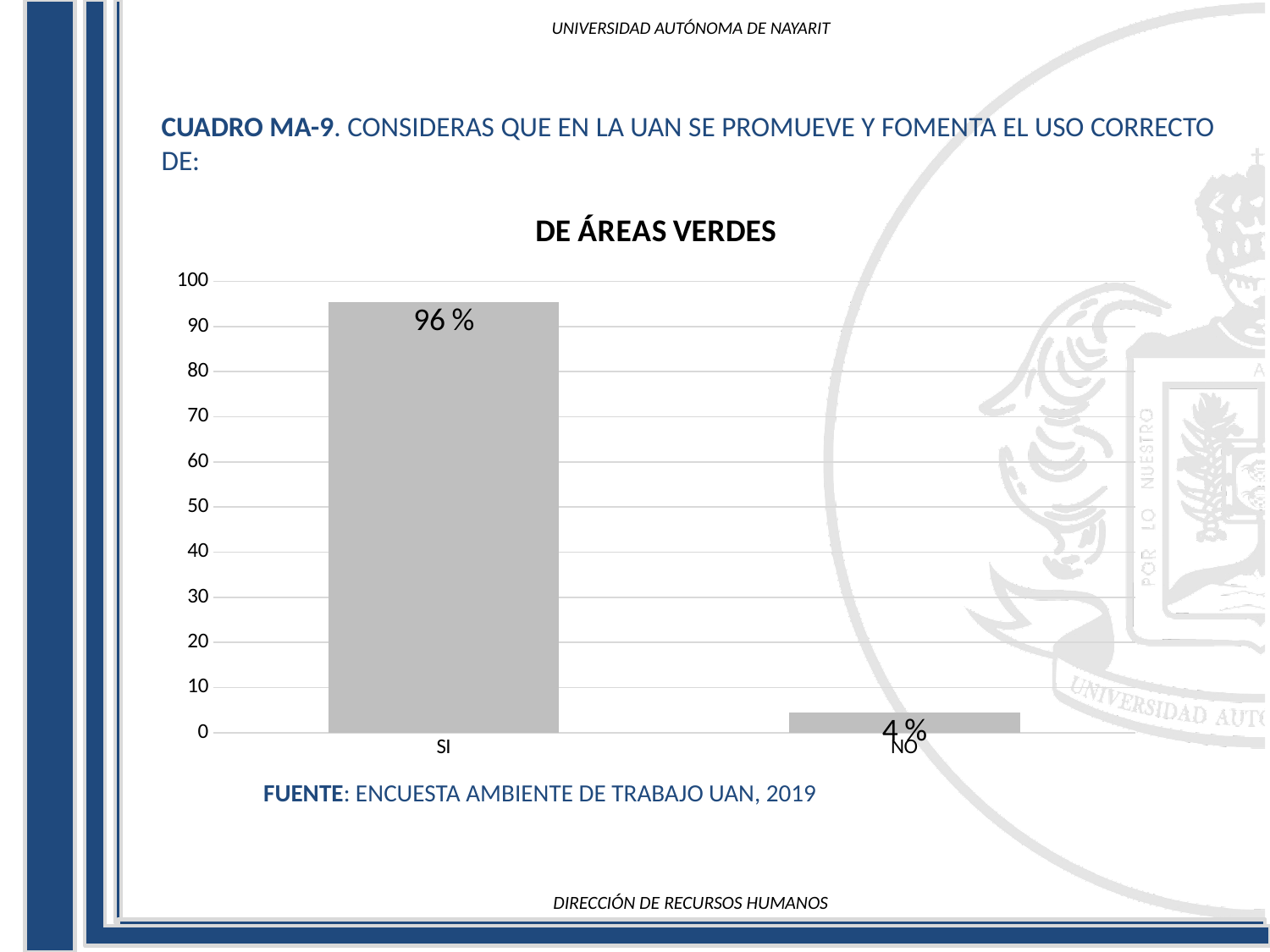
Is the value for NO greater or less than 10? less Which is larger, the value for SI or the value for NO? SI What is the value for NO? 4 % Which category has the lowest value? NO What is the title of the chart? DE ÁREAS VERDES What is the source cited below the chart? ENCUESTA AMBIENTE DE TRABAJO UAN, 2019 Which category has the highest value? SI What is the difference between the values for SI and NO? 92 % How many categories are shown on the x axis? 2 Is the value for SI greater or less than 90? greater What is the value for SI? 96 % What kind of chart is shown? bar chart